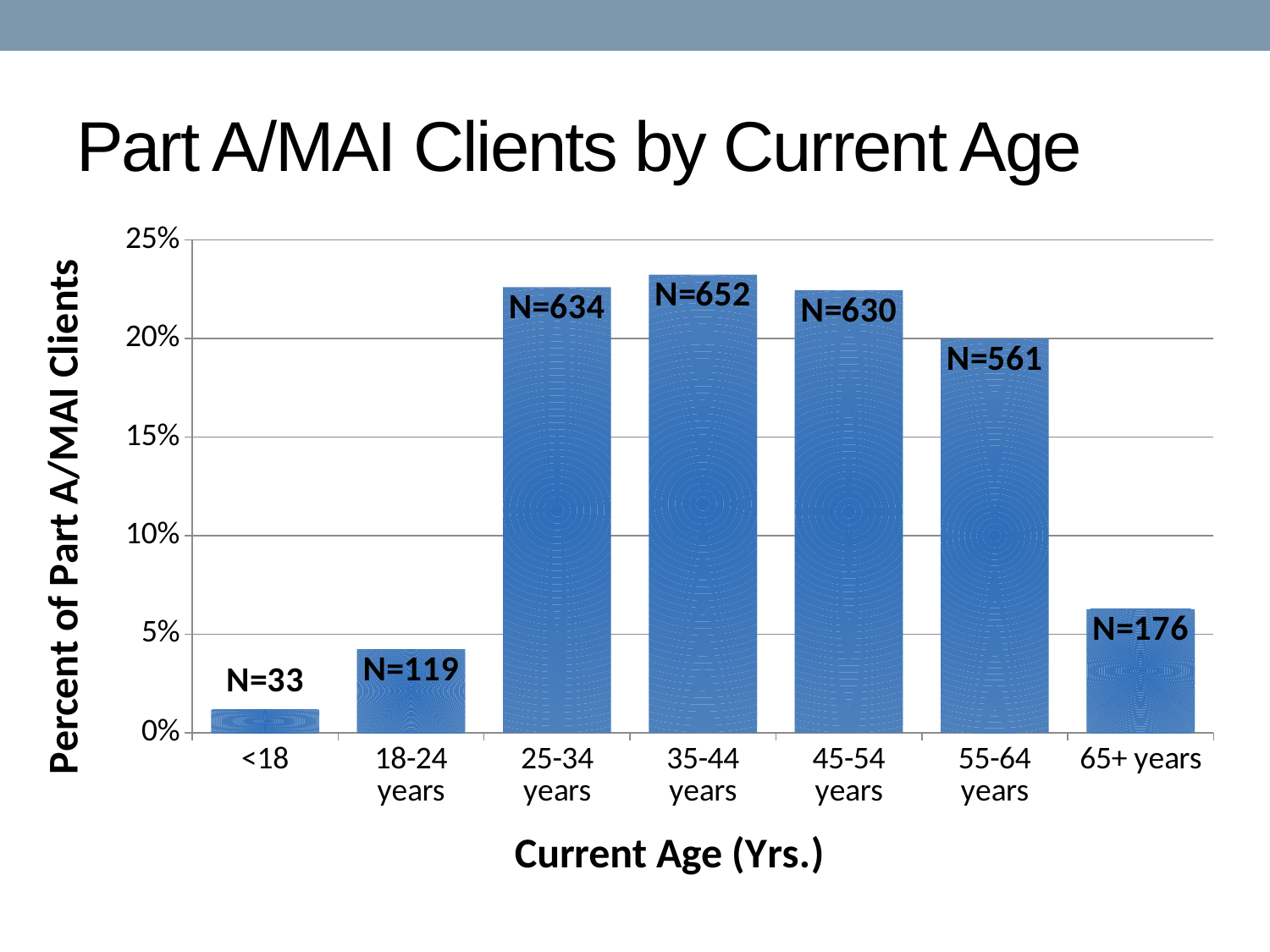
Is the percent value for the 25-34 years group greater or less than 20%? greater What is the N value shown for the 65+ years age group? N=176 What is the difference between the N values for the 35-44 years and 25-34 years groups? 18 What is the title of the y axis? Percent of Part A/MAI Clients What is the N value shown for the <18 age group? N=33 Which age group has the lowest percent of Part A/MAI clients? <18 How many age groups are shown on the x axis? 7 What is the N value shown for the 35-44 years age group? N=652 Which age group has the highest percent of Part A/MAI clients? 35-44 years What kind of chart is shown on the slide? Bar chart Is the percent value for the 18-24 years group greater or less than 5%? less Which age group has a larger N value, 45-54 years or 55-64 years? 45-54 years